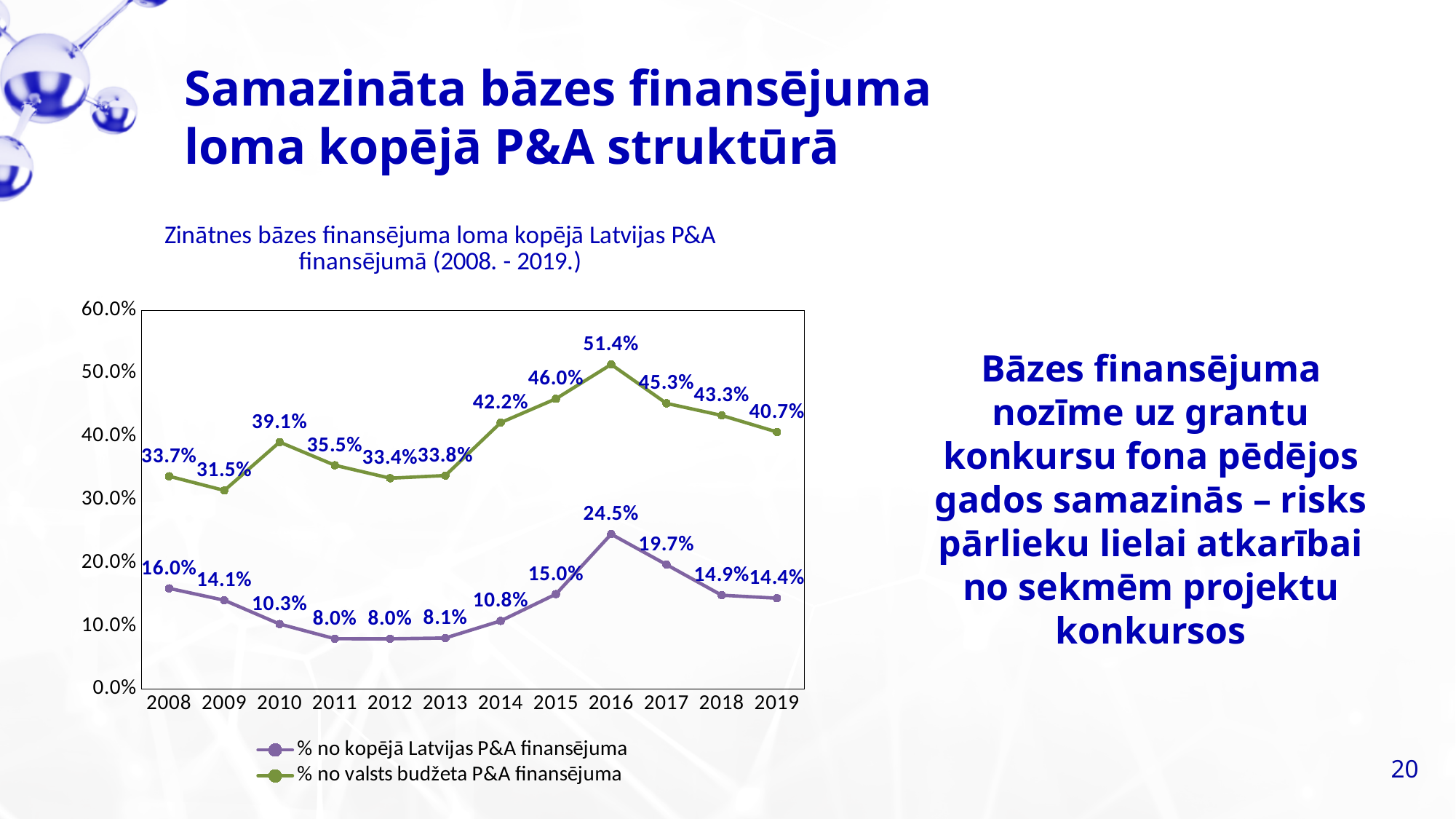
How many series does the legend list? 2 What is the title of the chart? Zinātnes bāzes finansējuma loma kopējā Latvijas P&A finansējumā (2008. - 2019.) What is the value of '% no kopējā Latvijas P&A finansējuma' in 2019? 14.4% How many years are plotted on the x axis? 12 Does '% no kopējā Latvijas P&A finansējuma' rise or fall from 2016 to 2019? fall What type of chart is shown on the slide? line chart What is the difference between the '% no valsts budžeta P&A finansējuma' values in 2016 and 2019? 10.7% What is the value of '% no valsts budžeta P&A finansējuma' in 2016? 51.4% Is the value of '% no valsts budžeta P&A finansējuma' in 2016 greater or less than 50.0%? greater In which year is '% no valsts budžeta P&A finansējuma' lowest? 2009 Which is larger: '% no kopējā Latvijas P&A finansējuma' in 2008 or in 2013? 2008 In which year is '% no kopējā Latvijas P&A finansējuma' highest? 2016